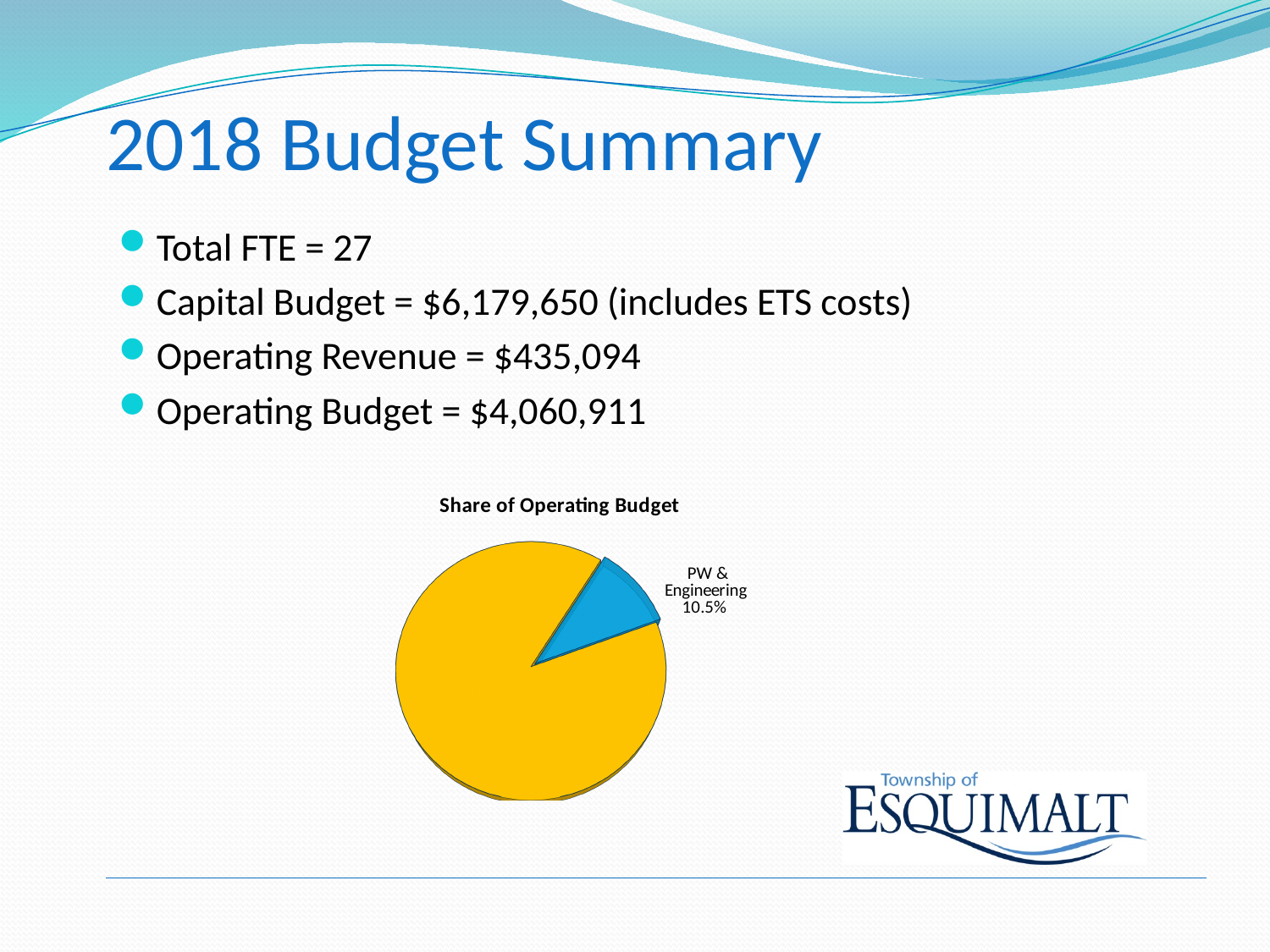
What is the title of the chart on the slide? Share of Operating Budget Is the PW & Engineering slice the larger or the smaller slice of the pie? smaller Is the share for PW & Engineering greater or less than 50%? less How many slices does the pie chart have? 2 What kind of chart is shown on the slide? pie chart What colour is the PW & Engineering slice in the pie chart? blue What share of the operating budget does the PW & Engineering slice represent? 10.5%